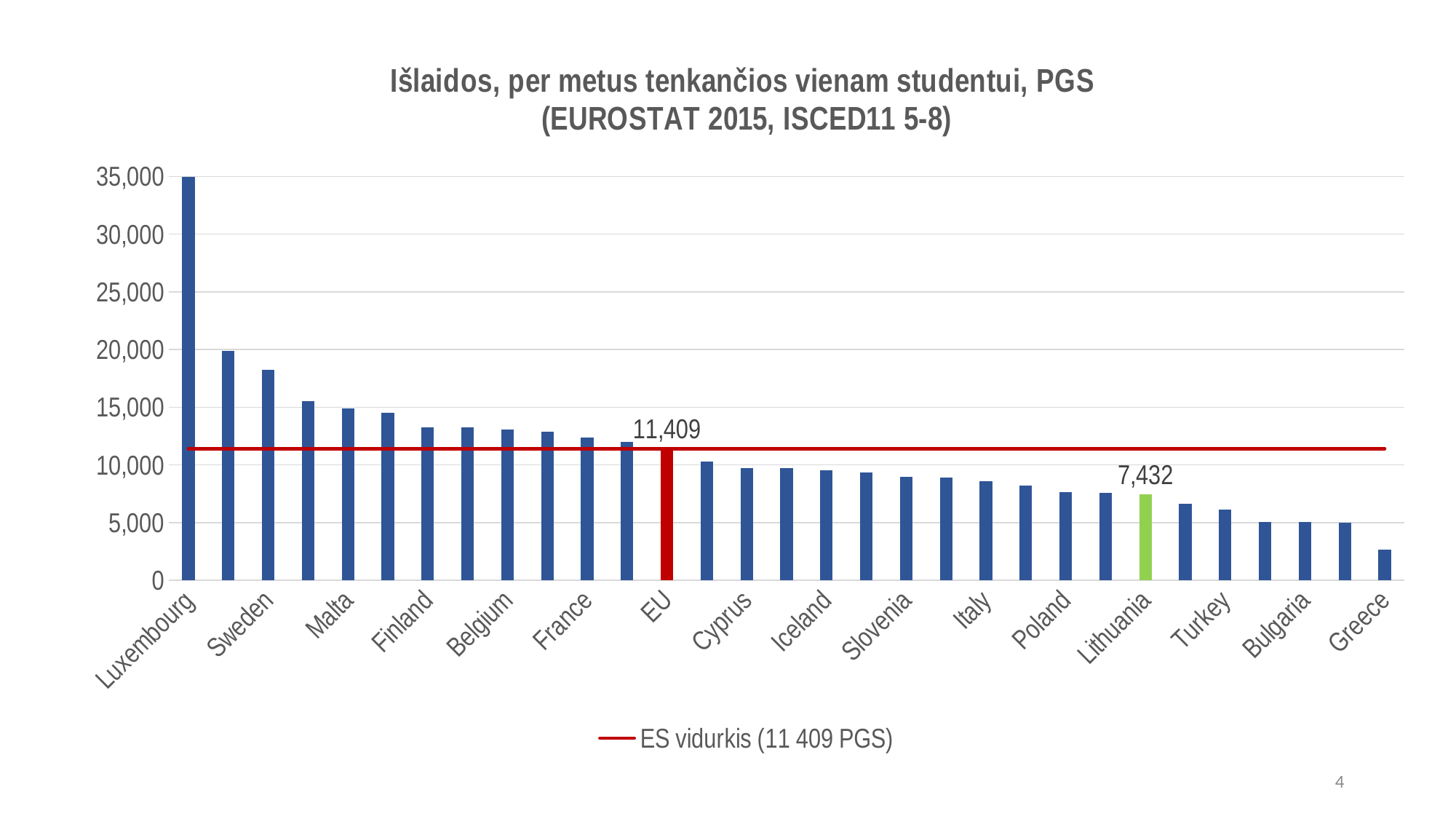
Do the values rise or fall from left to right along the x axis? fall Is the value for Greece greater or less than 5,000? less Is the value for Luxembourg greater or less than 30,000? greater Which is larger, the value for Lithuania or the value for EU? EU What is the value shown for Lithuania? 7,432 Is the value for Sweden greater or less than 15,000? greater Which country has the highest expenditure per student? Luxembourg What is the difference between the EU value and the Lithuania value? 3,977 What kind of chart is shown on the slide? bar and line chart Which country has the lowest expenditure per student? Greece What is the value shown for EU? 11,409 Which is larger, the value for Luxembourg or the value for Sweden? Luxembourg